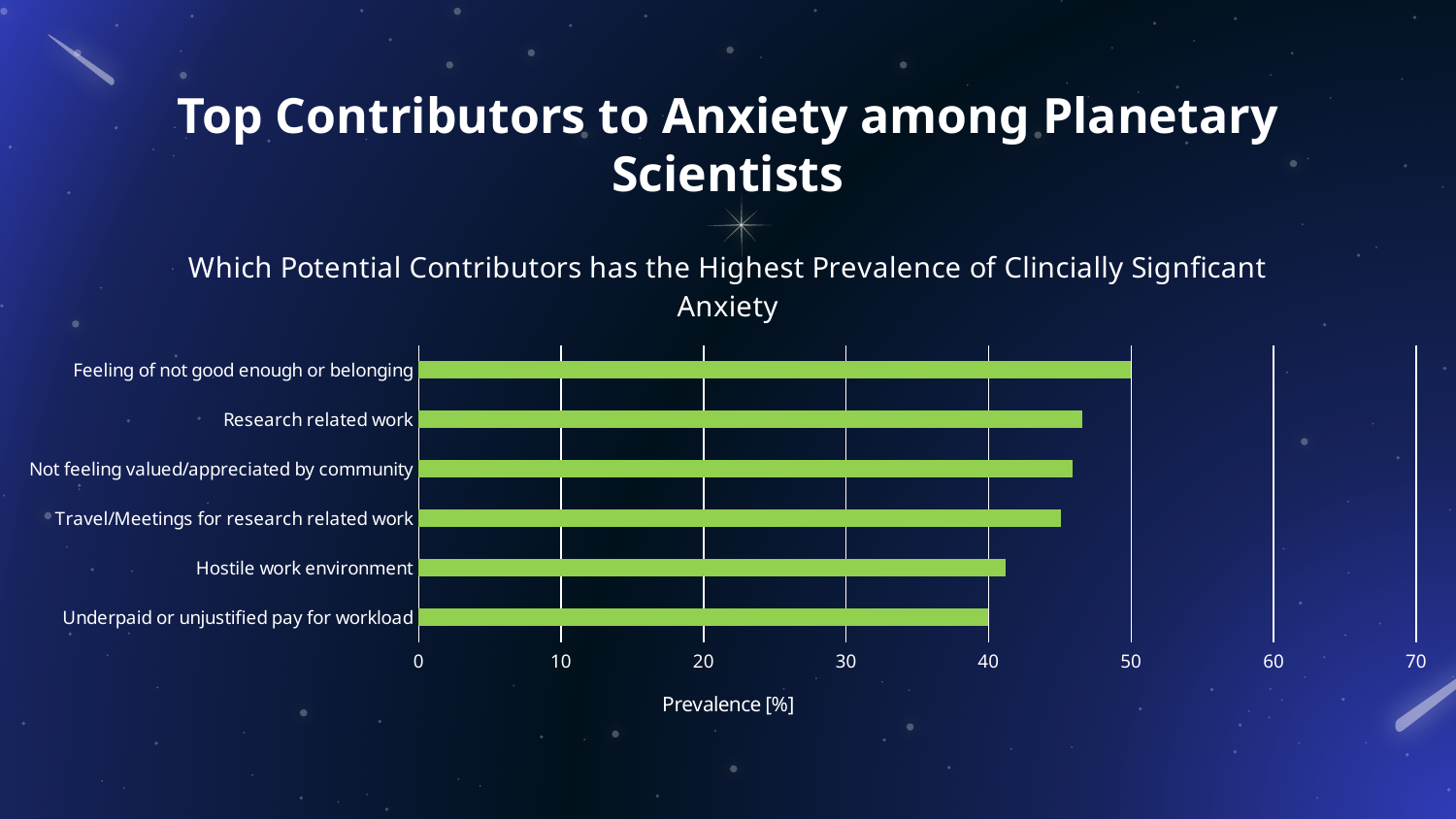
Is the value for 'Underpaid or unjustified pay for workload' greater or less than 50? less Which has a larger value: 'Research related work' or 'Hostile work environment'? Research related work Is the value for 'Travel/Meetings for research related work' greater or less than 50? less How many contributors (categories) are plotted in the chart? 6 What is the highest tick value shown on the horizontal axis? 70 Which has a larger value: 'Feeling of not good enough or belonging' or 'Underpaid or unjustified pay for workload'? Feeling of not good enough or belonging Is the value for 'Hostile work environment' greater or less than 30? greater Which contributor has the highest prevalence in the chart? Feeling of not good enough or belonging What kind of chart is shown on the slide? Bar chart What is the label of the horizontal axis of the chart? Prevalence [%]